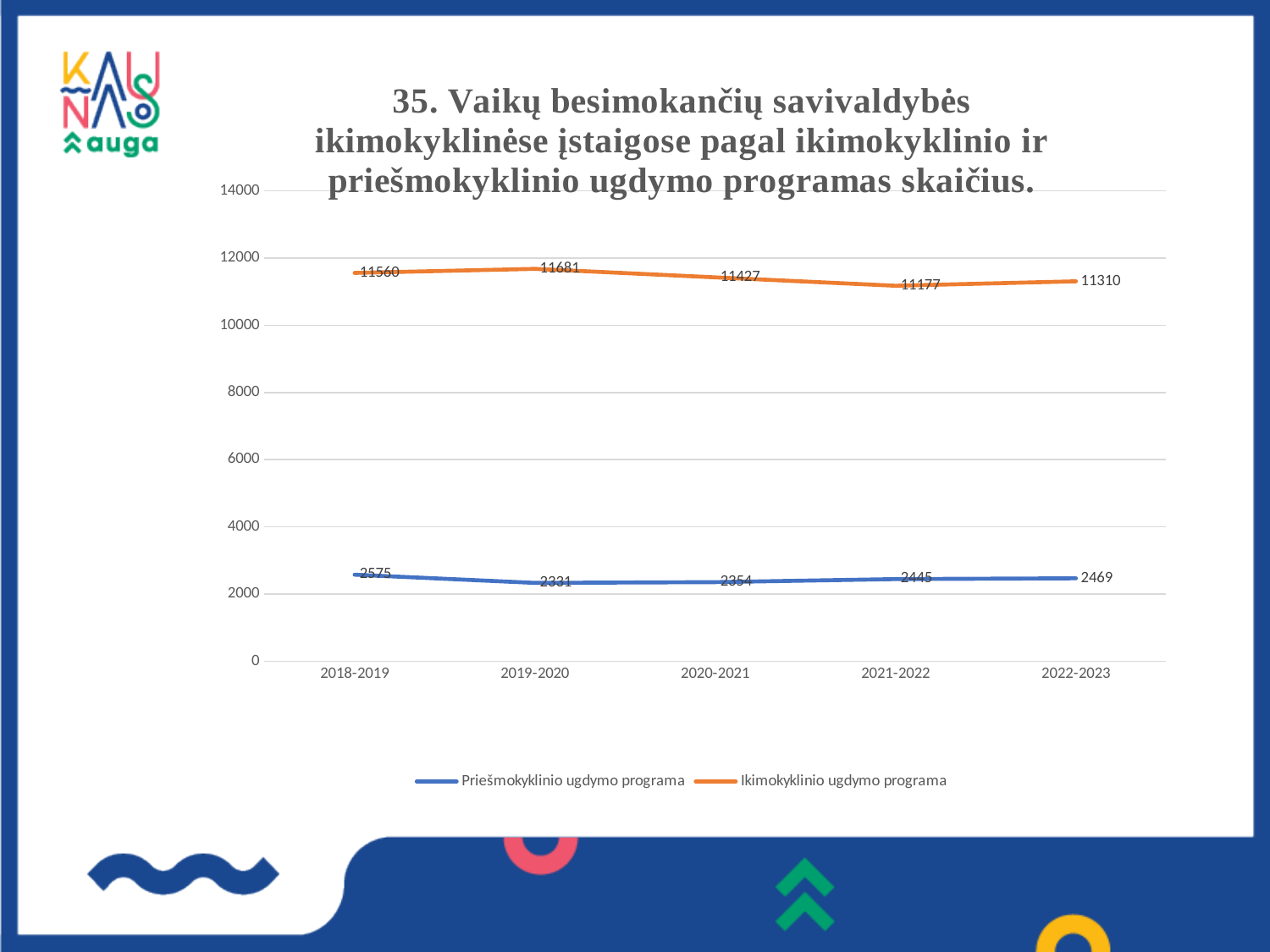
Which colour is used for the Ikimokyklinio ugdymo programa line? orange What is the value for Ikimokyklinio ugdymo programa in 2022-2023? 11310 What kind of chart is shown on the slide? line chart In which period is the Ikimokyklinio ugdymo programa value highest? 2019-2020 How many periods are shown on the x axis? 5 Which is larger: the Priešmokyklinio ugdymo programa value in 2018-2019 or in 2022-2023? 2018-2019 In which period is the Priešmokyklinio ugdymo programa value lowest? 2019-2020 What is the difference between the Ikimokyklinio ugdymo programa values in 2018-2019 and 2021-2022? 383 How many series does the legend list? 2 Is the value for Ikimokyklinio ugdymo programa in 2020-2021 greater or less than 12000? less What is the value for Ikimokyklinio ugdymo programa in 2019-2020? 11681 What is the value for Priešmokyklinio ugdymo programa in 2021-2022? 2445